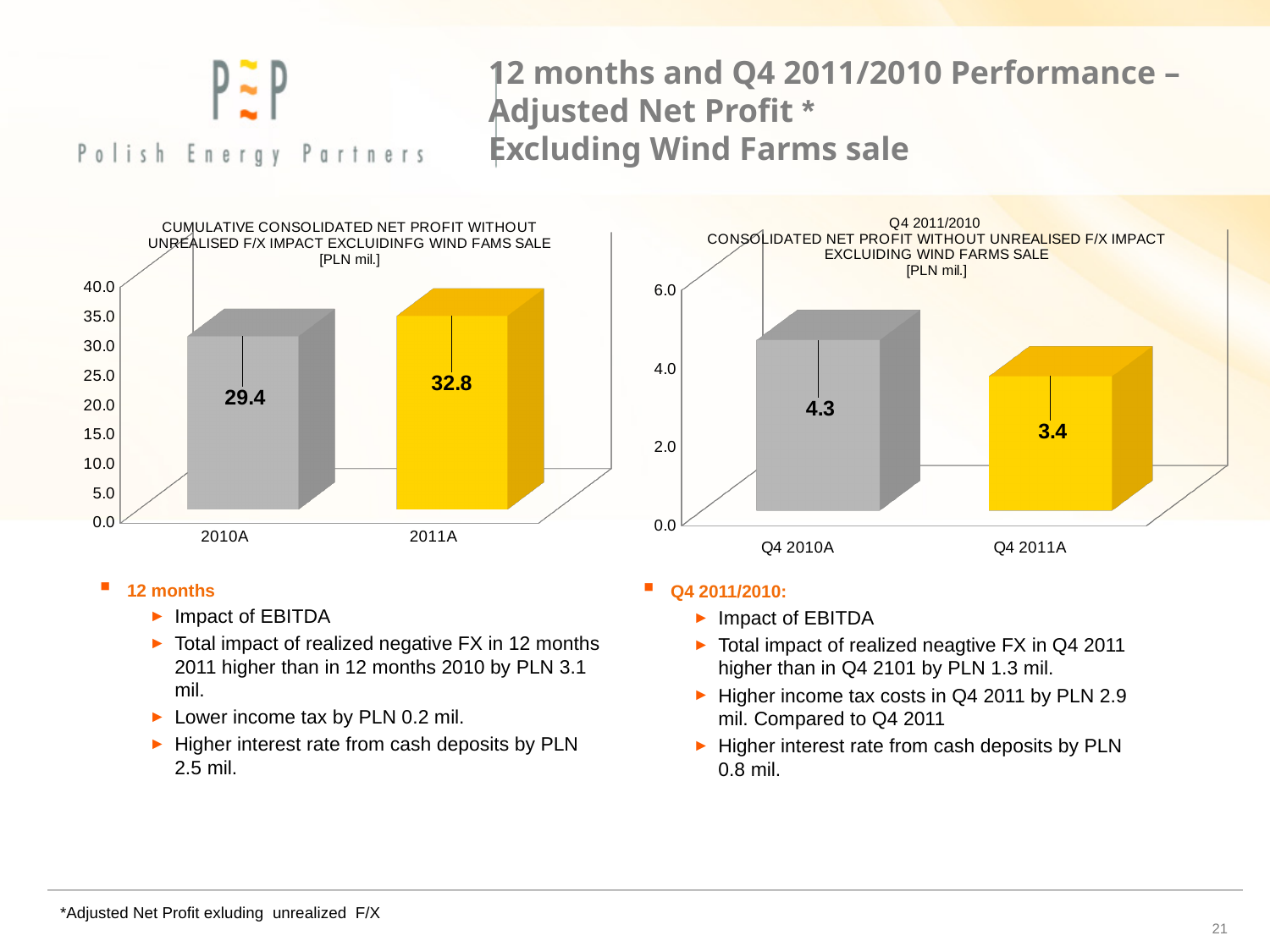
In the right chart (Q4 2011/2010 consolidated net profit), which quarter has the lower value? Q4 2011A What kind of chart is the left chart (cumulative consolidated net profit)? bar chart In the right chart (Q4 2011/2010 consolidated net profit), what is the value for Q4 2011A? 3.4 In the left chart (cumulative consolidated net profit), what is the difference between the 2011A and 2010A values? 3.4 In the left chart (cumulative consolidated net profit), what is the value for 2011A? 32.8 In the left chart (cumulative consolidated net profit), which year has the higher value? 2011A In the left chart (cumulative consolidated net profit), what is the value for 2010A? 29.4 In the right chart (Q4 2011/2010 consolidated net profit), what is the value for Q4 2010A? 4.3 In the left chart (cumulative consolidated net profit), how many bars are plotted? 2 In the right chart (Q4 2011/2010 consolidated net profit), what is the difference between the Q4 2010A and Q4 2011A values? 0.9 In the right chart (Q4 2011/2010 consolidated net profit), do the values rise or fall from Q4 2010A to Q4 2011A? fall In the right chart (Q4 2011/2010 consolidated net profit), what unit is stated in the chart title? PLN mil.